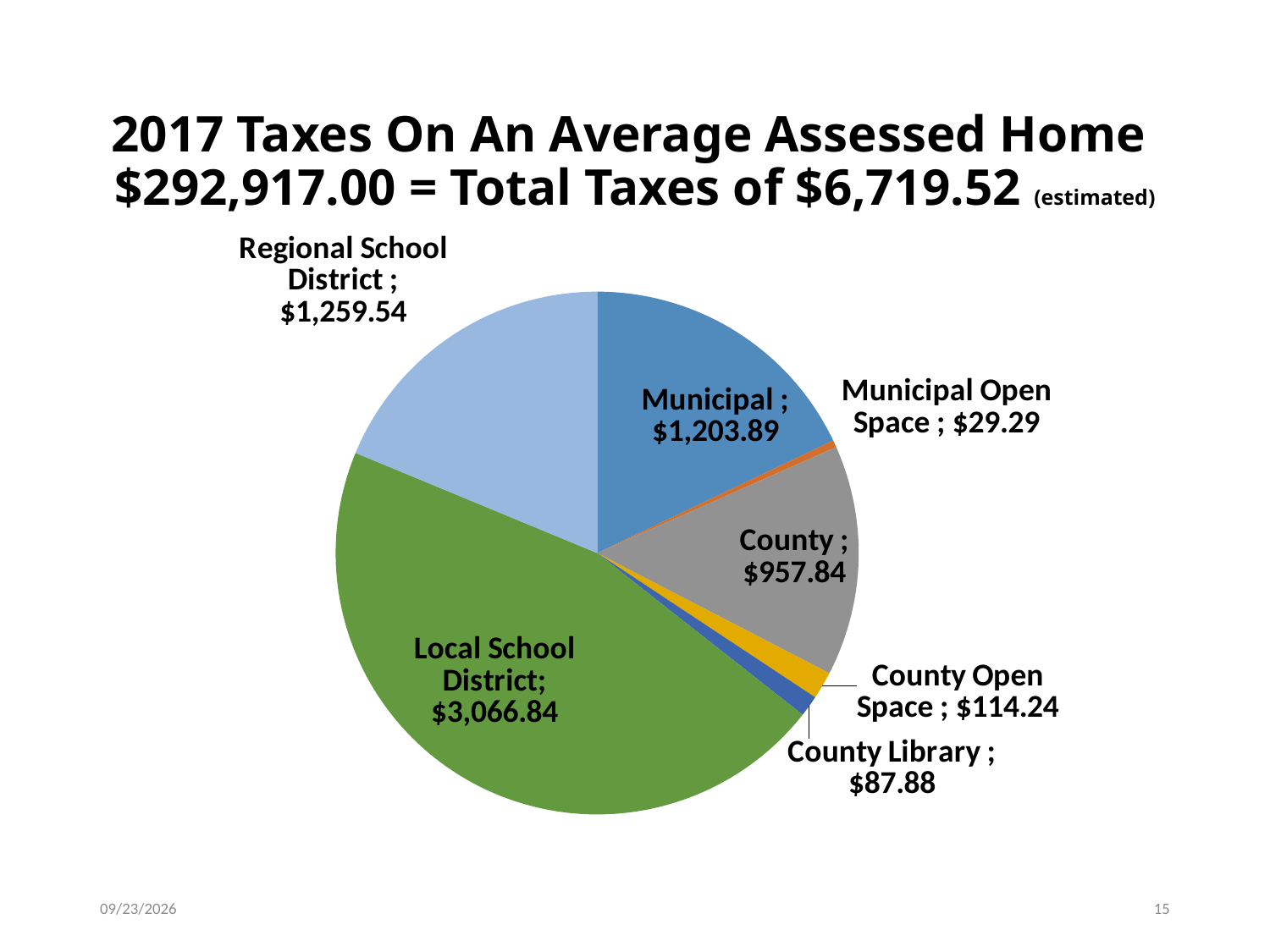
What is the value for Municipal Open Space? $29.29 Which category has the smallest slice? Municipal Open Space What total taxes amount is stated in the chart title? $6,719.52 What is the value for County? $957.84 What is the difference between Local School District and Regional School District? $1,807.30 What kind of chart is shown on the slide? pie chart How many slices does the pie chart have? 7 Which category has the largest slice? Local School District Which is larger, Regional School District or Municipal? Regional School District What is the value for County Library? $87.88 What is the value for Local School District? $3,066.84 What is the difference between County Open Space and County Library? $26.36